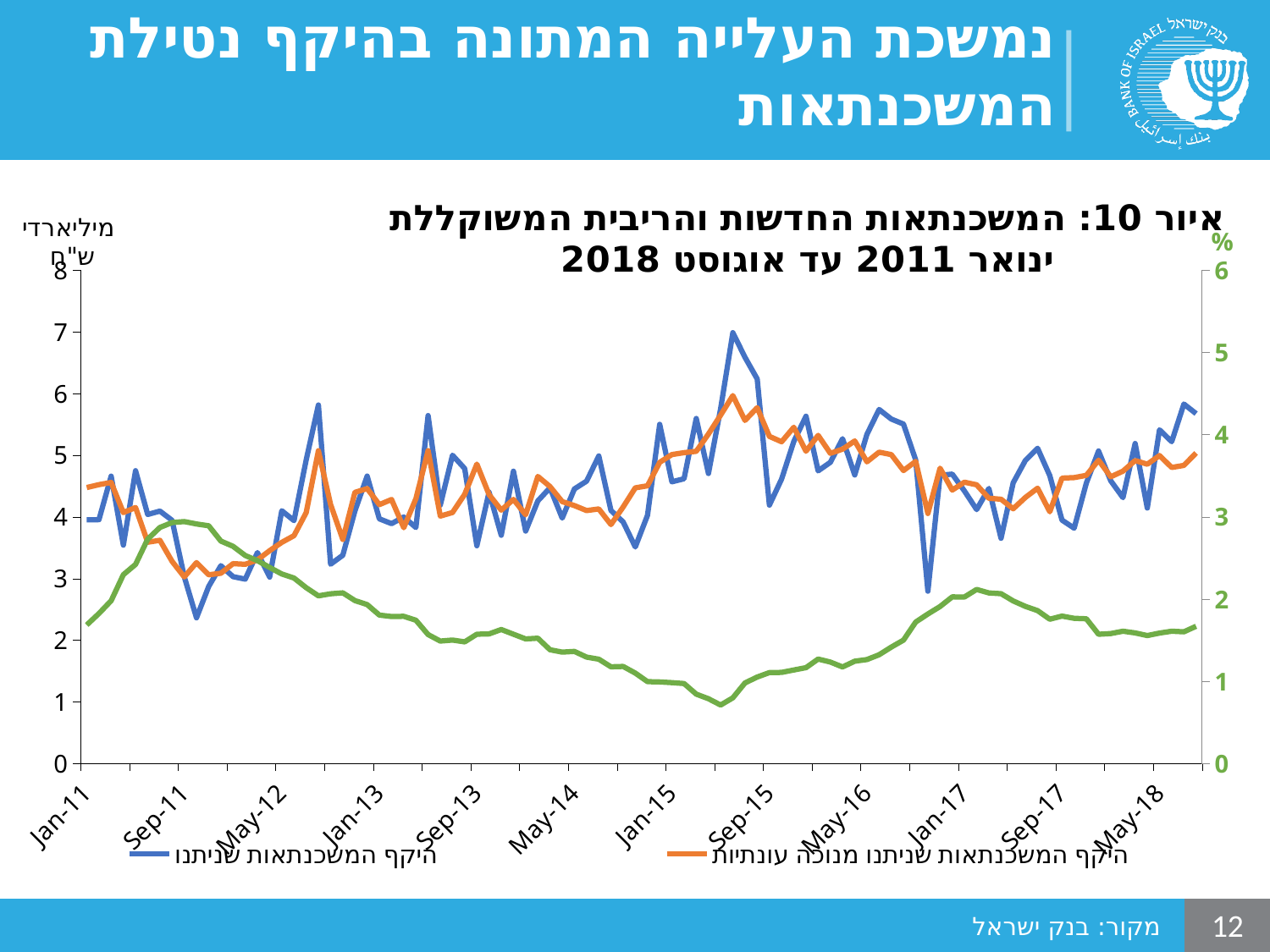
Is the peak value of the blue series (היקף המשכנתאות שניתנו) near Sep-15 greater or less than 6 on the left axis? greater Is the value of the orange series (היקף המשכנתאות שניתנו מנוכה עונתיות) at Jan-11 greater or less than 4 on the left axis? greater What kind of chart is shown on the slide? line chart What is the title of the chart? איור 10: המשכנתאות החדשות והריבית המשוקללת ינואר 2011 עד אוגוסט 2018 Does the green series rise or fall between Sep-11 and Sep-15? fall Is the lowest value of the blue series (היקף המשכנתאות שניתנו), near Jan-17, greater or less than 3 on the left axis? less How many series does the chart's legend list? 2 What unit is shown on the left vertical axis of the chart? מיליארדי ש"ח Around which labelled date does the green series reach its lowest value? Sep-15 How many date labels are shown along the x axis of the chart? 12 Around which labelled date does the blue series (היקף המשכנתאות שניתנו) reach its highest value? Sep-15